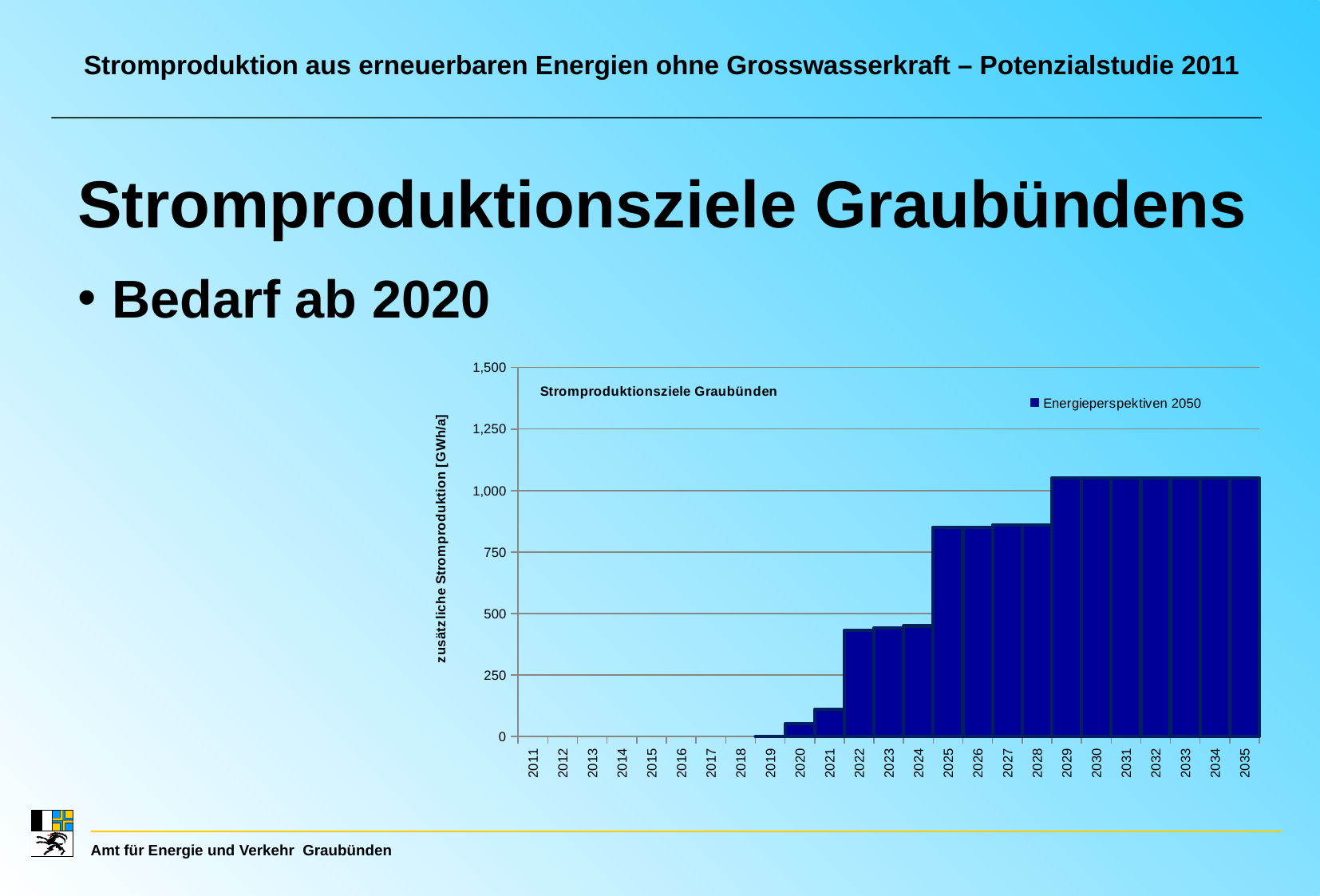
Which year has the larger value, 2022 or 2025? 2025 Do the values generally rise or fall from 2011 to 2035? rise Is the value for 2030 greater or less than 1,000? greater What kind of chart is shown on the slide? bar chart How many series does the chart legend list? 1 Is the value for 2035 greater or less than 1,250? less Is the value for 2022 greater or less than 500? less What is the name of the series shown in the chart legend? Energieperspektiven 2050 What is the title printed inside the chart? Stromproduktionsziele Graubünden How many years are shown on the x axis of the chart? 25